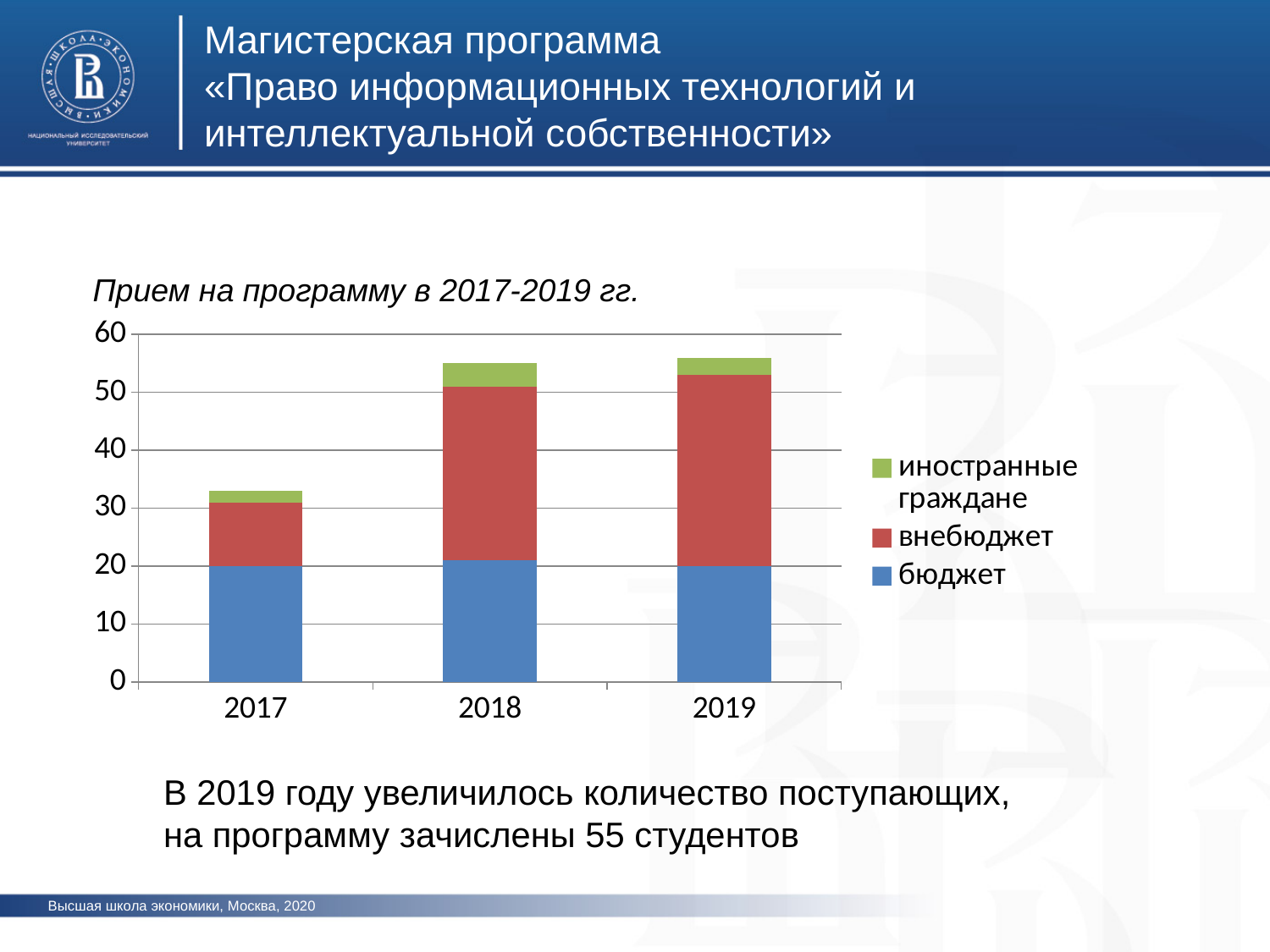
What is the title of the chart? Прием на программу в 2017-2019 гг. What kind of chart is shown on the slide? stacked bar chart Do the total bars rise or fall from 2017 to 2019? rise Which year has the larger внебюджет segment, 2017 or 2018? 2018 How many years (categories) are shown on the x axis of the chart? 3 Is the бюджет segment for 2017 greater or less than 30? less Which series is shown in green in the chart? иностранные граждане Is the total bar for 2018 greater or less than 50? greater Is the total bar for 2019 greater or less than 60? less Which year has the lowest total bar in the chart? 2017 How many series does the chart legend list? 3